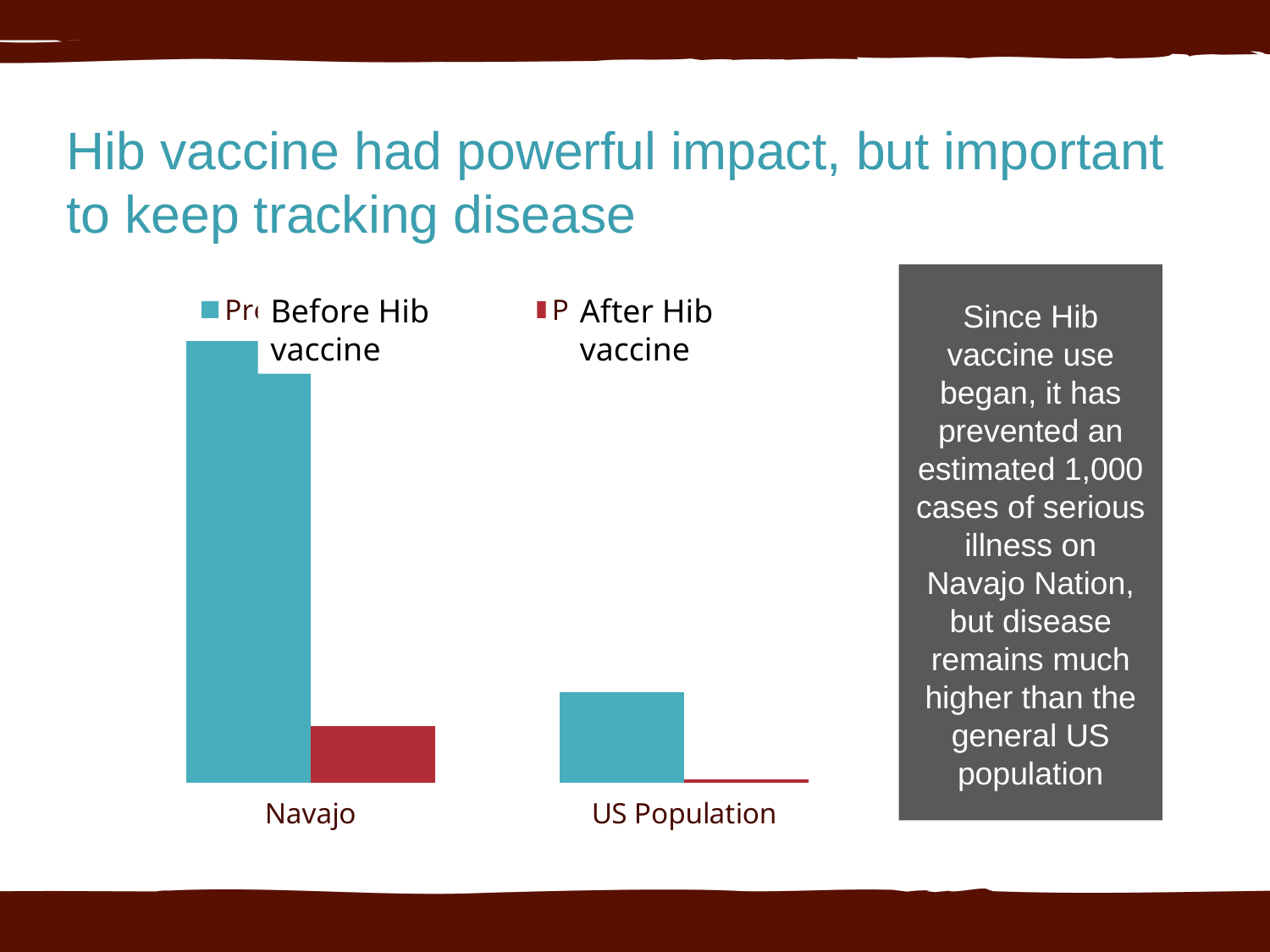
What colour are the After Hib vaccine bars in the chart? red What kind of chart is shown on the slide? bar chart Which category has the larger Before Hib vaccine bar, Navajo or US Population? Navajo How many categories are shown on the x axis of the chart? 2 Which category has the smallest After Hib vaccine bar? US Population How many series does the chart show? 2 Which category has the tallest bar in the chart? Navajo Which category has the larger After Hib vaccine bar, Navajo or US Population? Navajo What colour are the Before Hib vaccine bars in the chart? blue What are the two categories labelled on the x axis of the chart? Navajo and US Population For Navajo, which is larger: the Before Hib vaccine bar or the After Hib vaccine bar? Before Hib vaccine